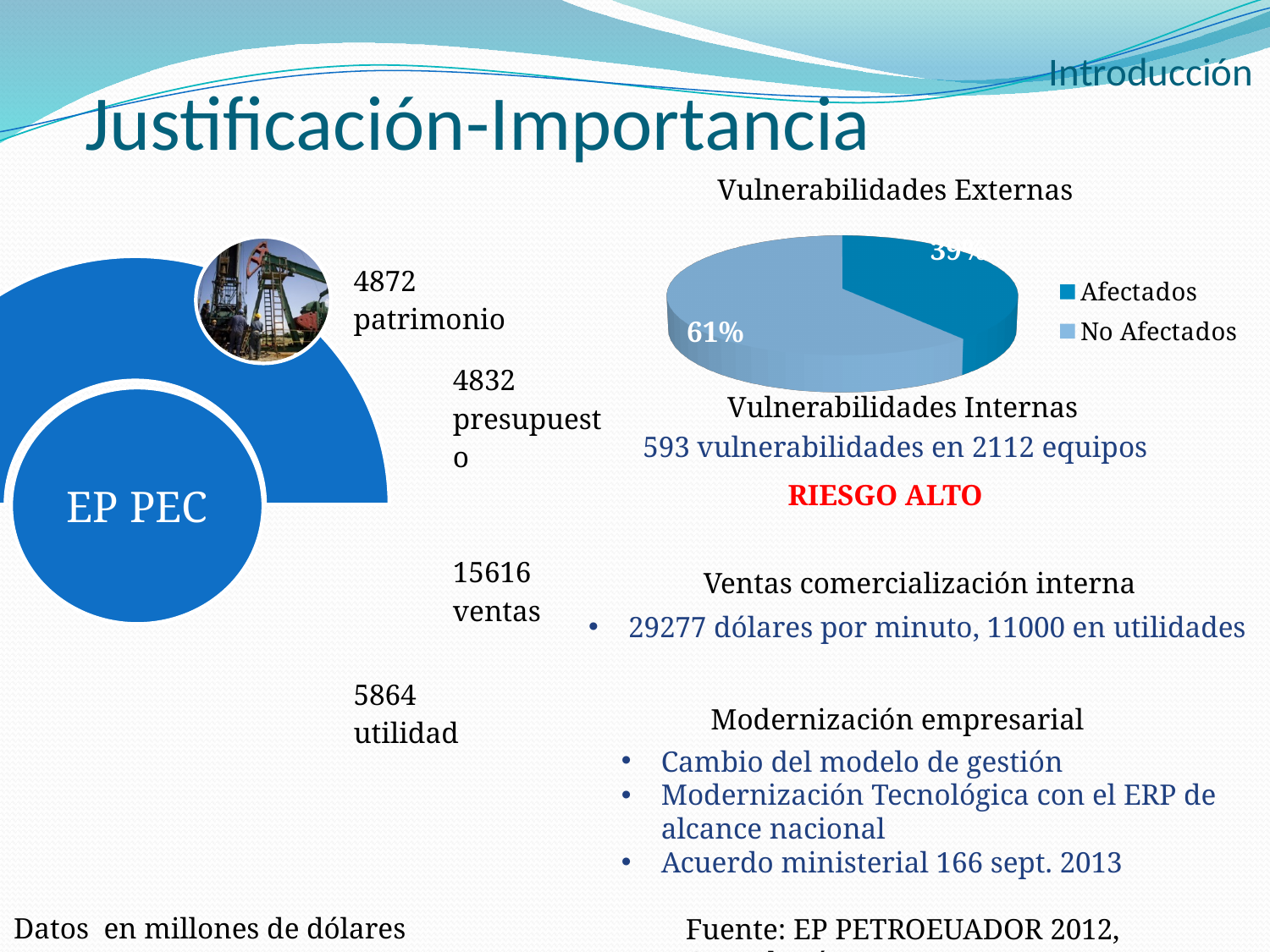
How many slices does the "Vulnerabilidades Externas" pie chart have? 2 What are the two legend entries of the "Vulnerabilidades Externas" pie chart? Afectados and No Afectados How many entries does the legend of the "Vulnerabilidades Externas" pie chart list? 2 What kind of chart is shown under the title "Vulnerabilidades Externas"? pie chart Which slice of the "Vulnerabilidades Externas" pie chart is the largest? No Afectados What is the title of the pie chart on the slide? Vulnerabilidades Externas Which slice of the "Vulnerabilidades Externas" pie chart is the smallest? Afectados In the "Vulnerabilidades Externas" pie chart, is the share for "No Afectados" greater or less than 50%? greater In the "Vulnerabilidades Externas" pie chart, which is larger: "Afectados" or "No Afectados"? No Afectados In the "Vulnerabilidades Externas" pie chart, what percentage is shown for "Afectados"? 39% In the "Vulnerabilidades Externas" pie chart, what percentage is shown for "No Afectados"? 61% In the "Vulnerabilidades Externas" pie chart, by how many percentage points does "No Afectados" exceed "Afectados"? 22 percentage points